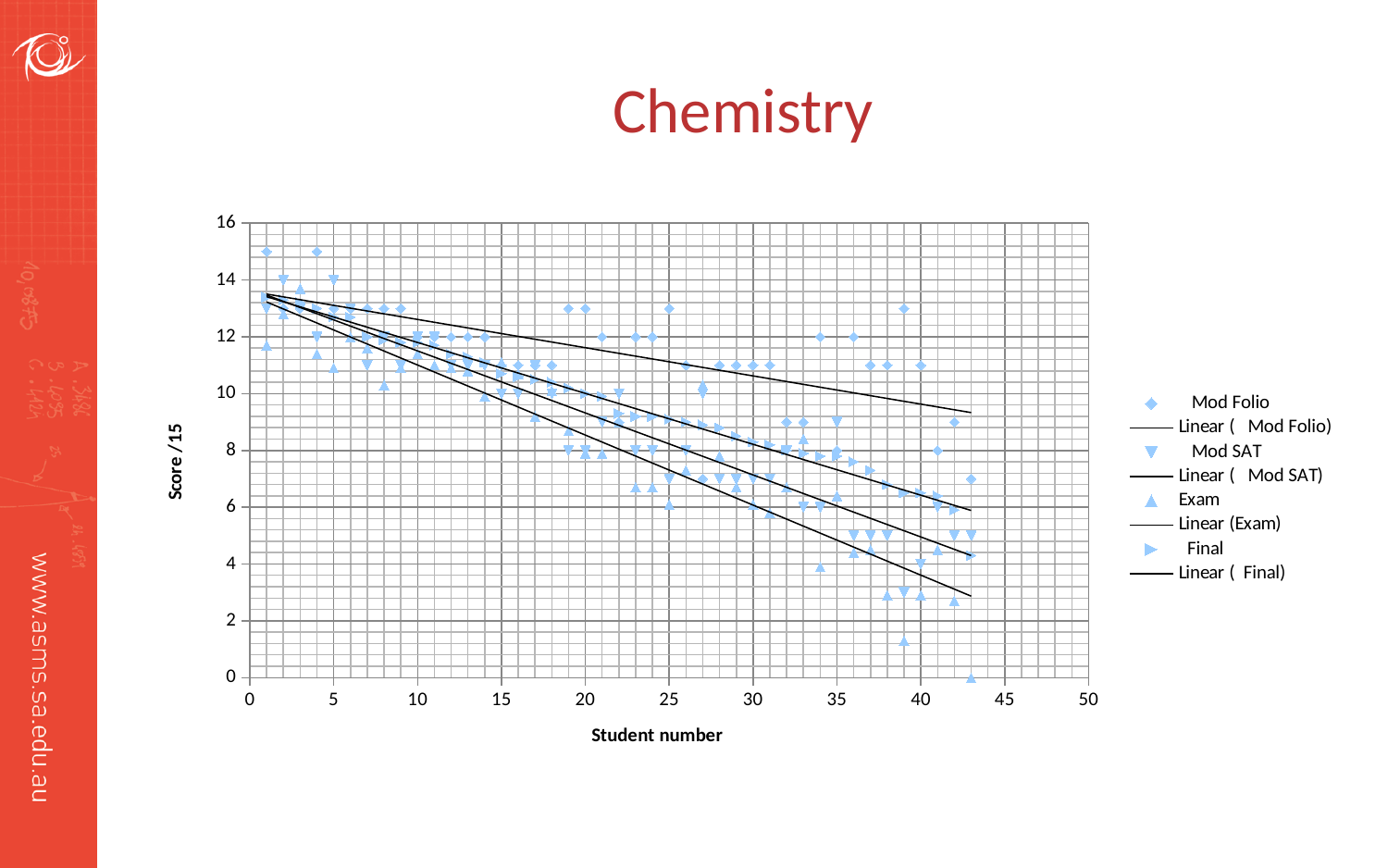
Do the scores generally rise or fall as the student number increases? Fall What kind of chart is shown on the slide? Scatter chart Is the value of the Linear (Mod Folio) trendline at student number 40 greater or less than 8? greater What is the maximum value shown on the vertical axis? 16 What is the title of the chart? Chemistry Which linear trendline is the lowest at the right-hand end of the chart? Linear (Exam) How many entries does the chart's legend list? 8 What is the label of the chart's vertical axis? Score /15 Which linear trendline is the highest at the right-hand end of the chart? Linear (Mod Folio) How many data series (excluding the linear trendlines) are plotted on the chart? 4 Is the value of the Linear (Final) trendline at student number 40 greater or less than 6? greater At student number 40, which trendline is higher: Linear (Exam) or Linear (Final)? Linear (Final)